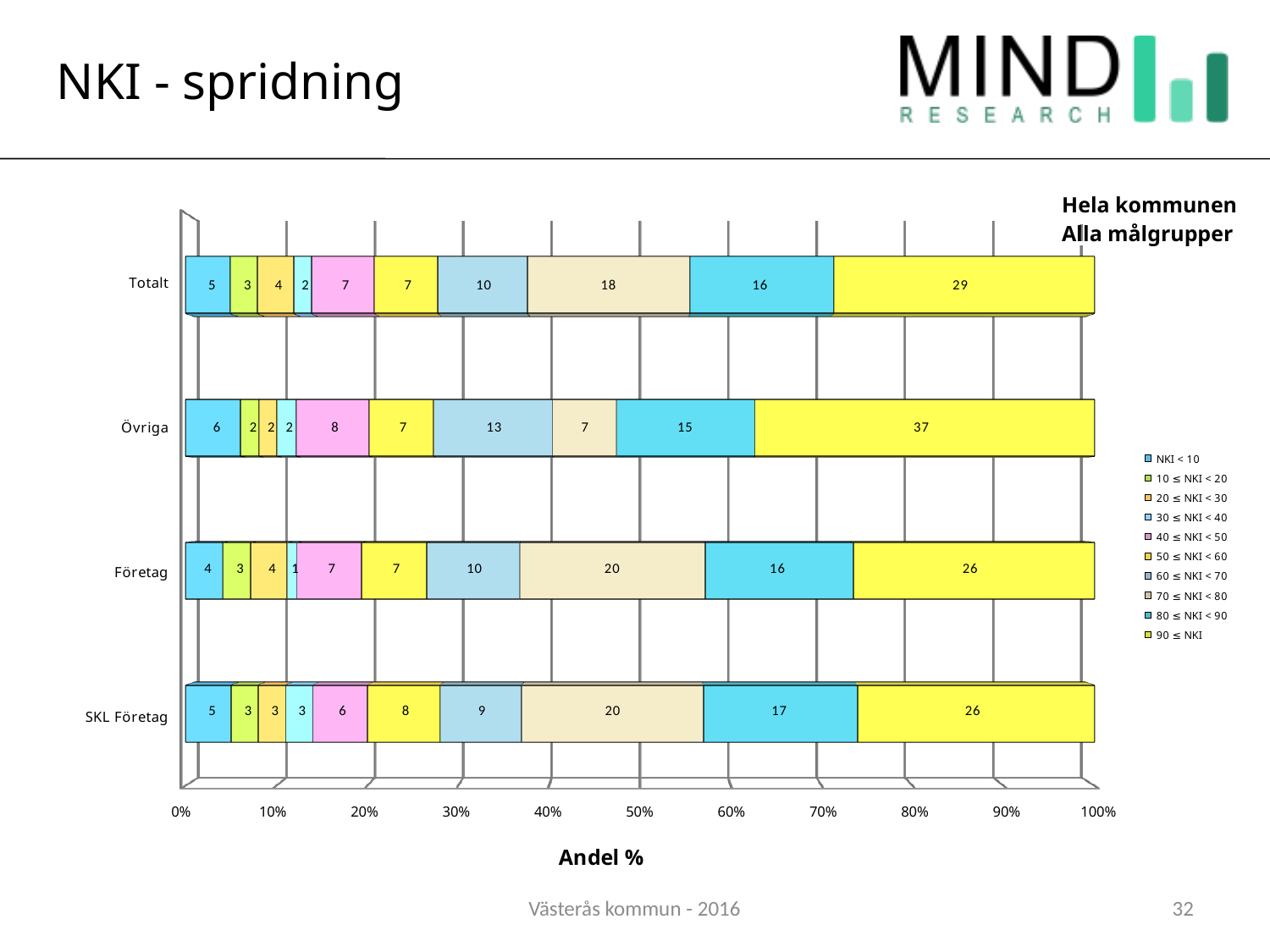
Which is larger, the 60 ≤ NKI < 70 value for Övriga or for Totalt? Övriga What is the title of the x axis? Andel % Which category has the lowest value for the 70 ≤ NKI < 80 segment? Övriga How many categories are shown on the y axis of the chart? 4 Which category has the highest value for the 90 ≤ NKI segment? Övriga What is the value of the 70 ≤ NKI < 80 segment for Företag? 20 How many series does the legend list? 10 What is the value of the 90 ≤ NKI segment for Övriga? 37 What is the difference between the 90 ≤ NKI values for Totalt and Företag? 3 What is the value of the 80 ≤ NKI < 90 segment for SKL Företag? 17 What kind of chart is shown on the slide? Stacked bar chart What is the total of the labelled segments in the SKL Företag bar? 100